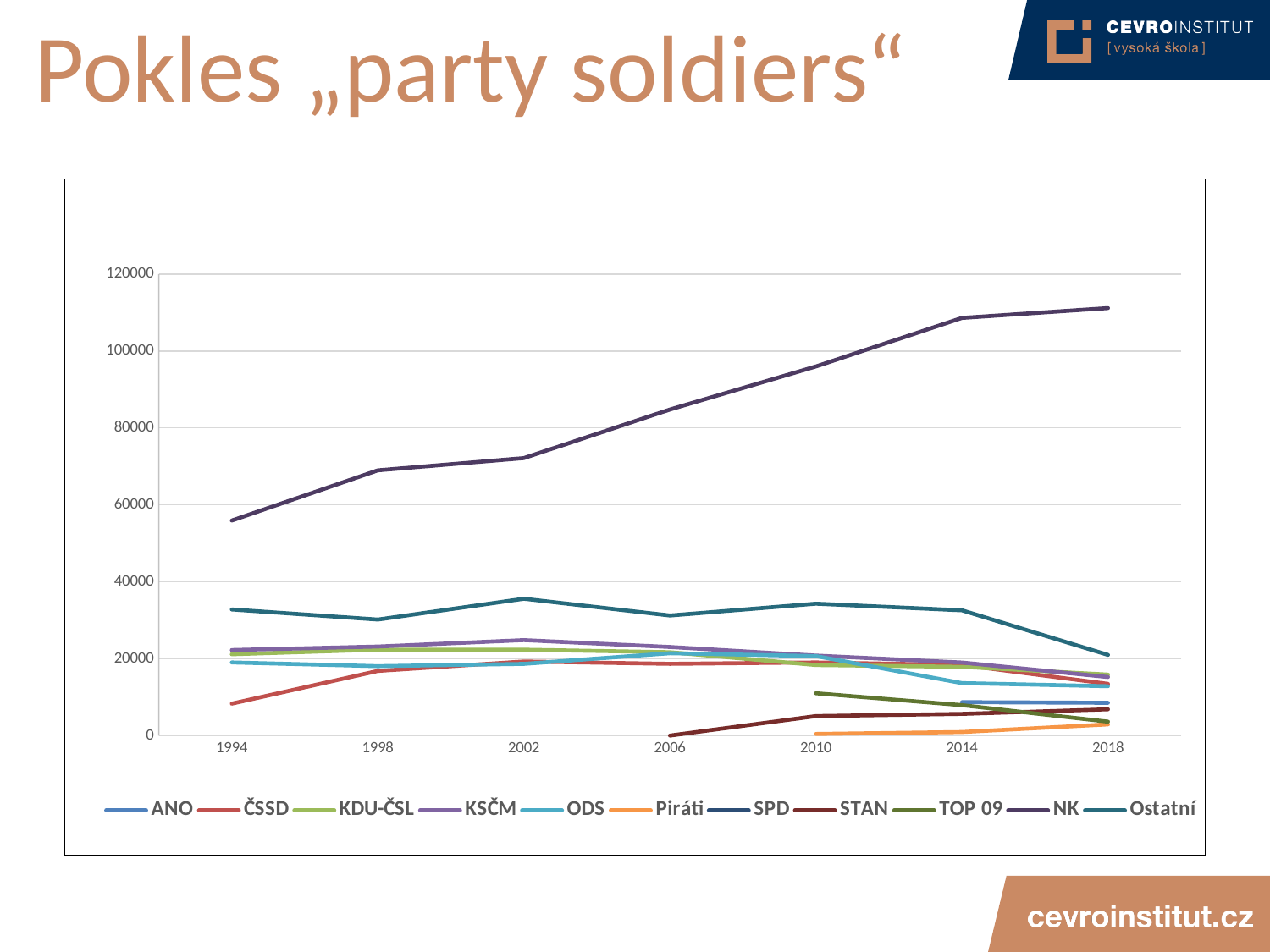
Which series has the highest value in 1994? NK Is the value for ČSSD in 1994 greater or less than 20000? less What kind of chart is shown on the slide? line chart Which series has the highest value in 2018? NK Is the value for NK in 2018 greater or less than 100000? greater Is the value for NK in 1994 greater or less than 60000? less Which is larger in 2010, the value for NK or the value for Ostatní? NK How many years are shown on the x axis? 7 Does the NK line rise or fall from 1994 to 2018? rise How many series does the legend list? 11 Does the Ostatní line rise or fall between 2014 and 2018? fall